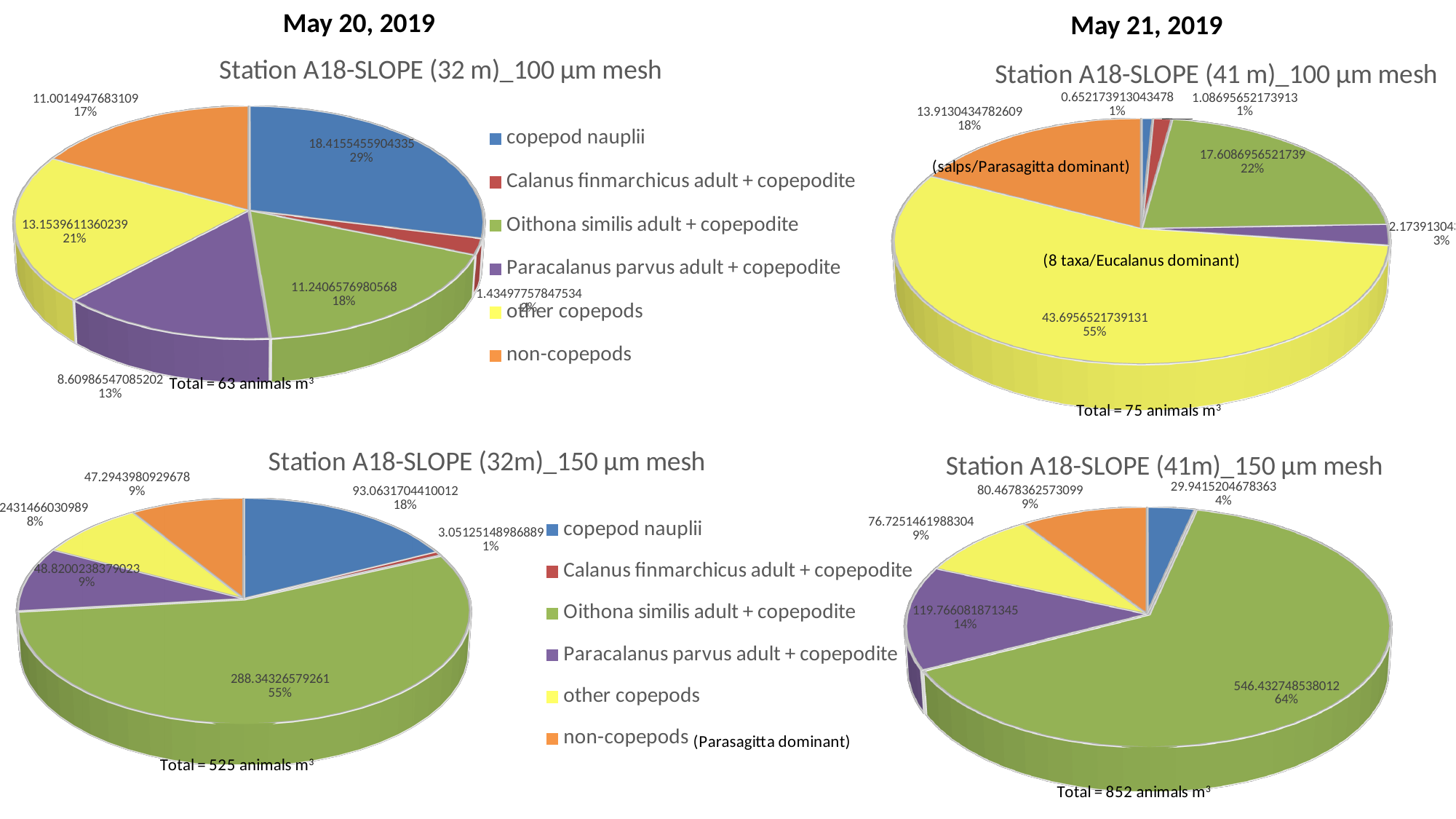
In the 'Station A18-SLOPE (41m)_150 µm mesh' chart, which category has the largest slice? Oithona similis adult + copepodite In the 'Station A18-SLOPE (32 m)_100 µm mesh' chart, what percentage share does copepod nauplii have? 29% In the 'Station A18-SLOPE (41 m)_100 µm mesh' chart, what is the total stated below the pie? Total = 75 animals m³ In the 'Station A18-SLOPE (41 m)_100 µm mesh' chart, what percentage share do other copepods have? 55% In the 'Station A18-SLOPE (32 m)_100 µm mesh' chart, which category has the largest slice? copepod nauplii In the 'Station A18-SLOPE (41m)_150 µm mesh' chart, what percentage share does Paracalanus parvus adult + copepodite have? 14% How many entries does the legend list for the 'Station A18-SLOPE (32 m)_100 µm mesh' chart? 6 In the 'Station A18-SLOPE (41m)_150 µm mesh' chart, which is larger: the value for non-copepods or the value for other copepods? non-copepods In the 'Station A18-SLOPE (32 m)_100 µm mesh' chart, which category has the smallest slice? Calanus finmarchicus adult + copepodite In the 'Station A18-SLOPE (41 m)_100 µm mesh' chart, what is the value for Oithona similis adult + copepodite? 17.6086956521739 In the 'Station A18-SLOPE (32m)_150 µm mesh' chart, what is the value for Oithona similis adult + copepodite? 288.34326579261